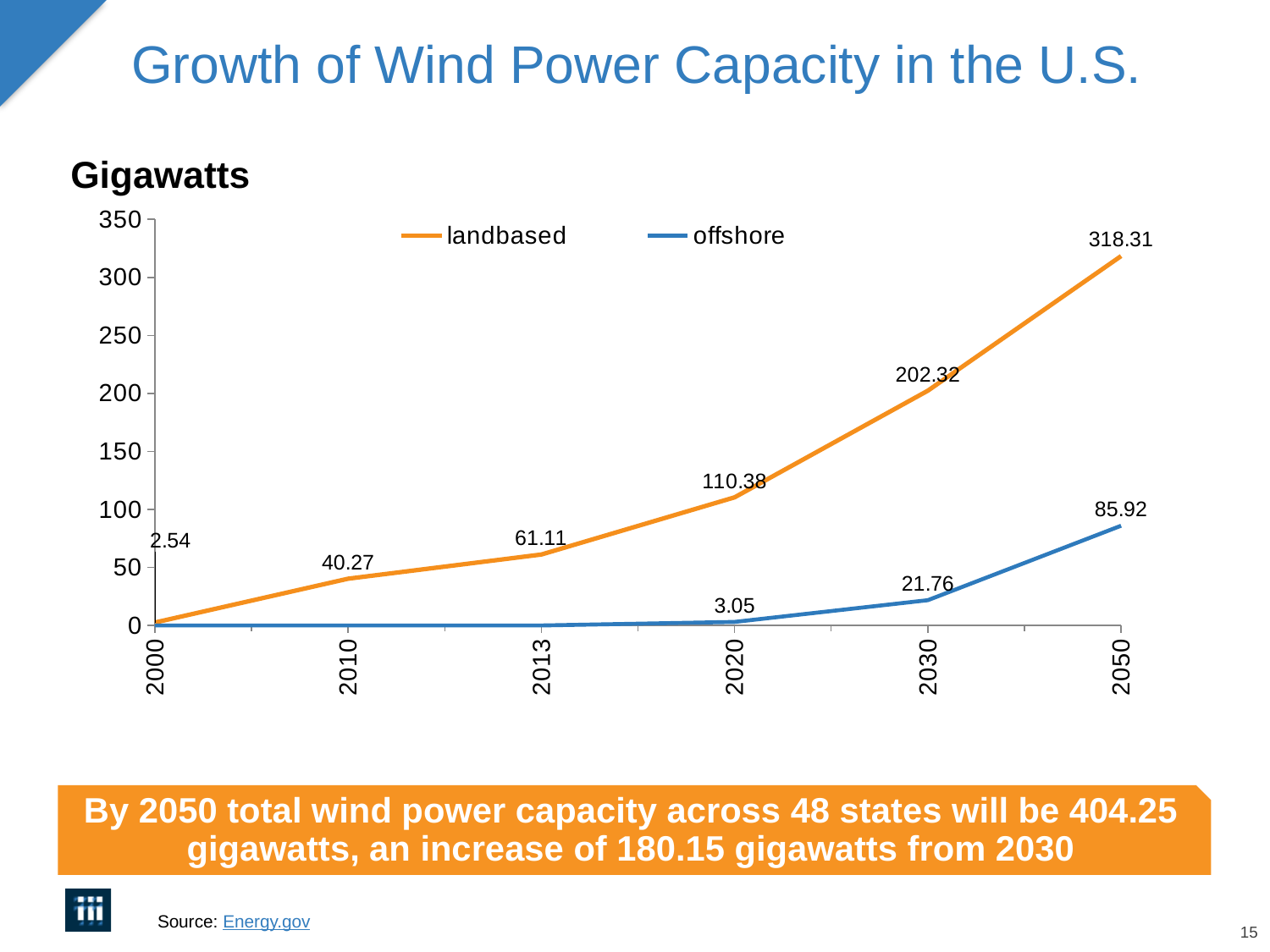
In which year is the landbased capacity highest? 2050 What kind of chart is shown on the slide? line chart How many years are shown on the x axis? 6 By how much does landbased capacity increase from 2030 to 2050? 115.99 In which year is the landbased capacity lowest? 2000 What is the offshore wind power capacity in 2030? 21.76 How many series does the legend list? 2 By how much does offshore capacity increase from 2030 to 2050? 64.16 What is the landbased wind power capacity in 2050? 318.31 In 2050, which series has the larger value, landbased or offshore? landbased What is the landbased wind power capacity in 2020? 110.38 Is the offshore value for 2013 greater or less than 50? less